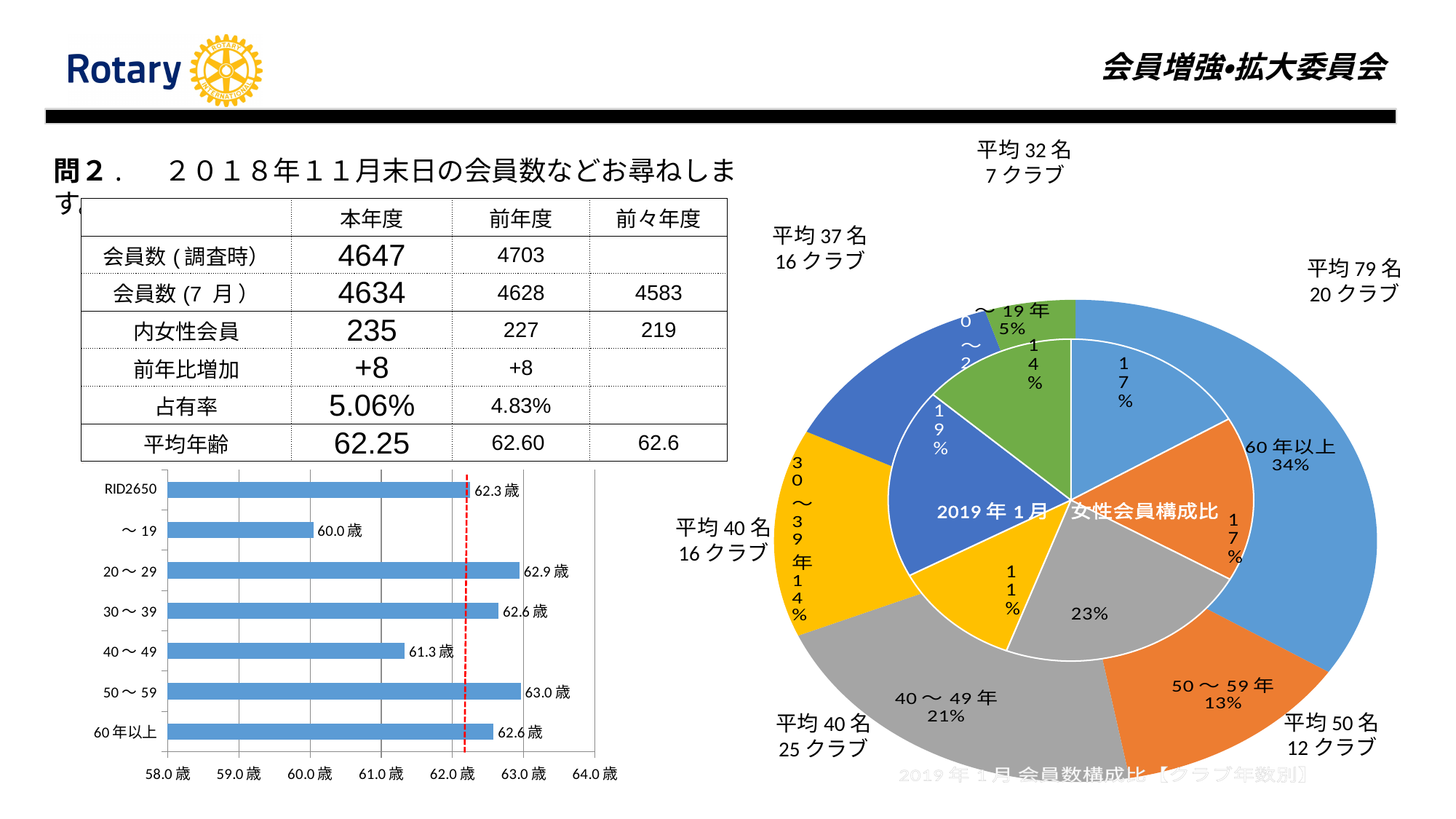
In the bar chart on the left, how many bars are plotted? 7 In the pie chart on the right, what percentage is shown for the 40～49年 slice of the outer ring? 21% In the pie chart on the right, what percentage is shown for the 50～59年 slice of the outer ring? 13% In the bar chart on the left, what is the value shown for RID2650? 62.3歳 In the pie chart on the right, what percentage is shown for the 60年以上 slice of the outer ring? 34% In the bar chart on the left, which category has the lowest average age? ～19 In the bar chart on the left, which is larger: the value for 30～39 or the value for 40～49? 30～39 In the bar chart on the left, what is the difference between the values for 50～59 and ～19? 3.0歳 In the pie chart on the right, which labelled slice of the outer ring is the smallest? ～19年 What kind of chart is the chart on the left of the slide? Bar chart In the bar chart on the left, which category has the highest average age? 50～59 In the bar chart on the left, what is the average age shown for the 50～59 category? 63.0歳